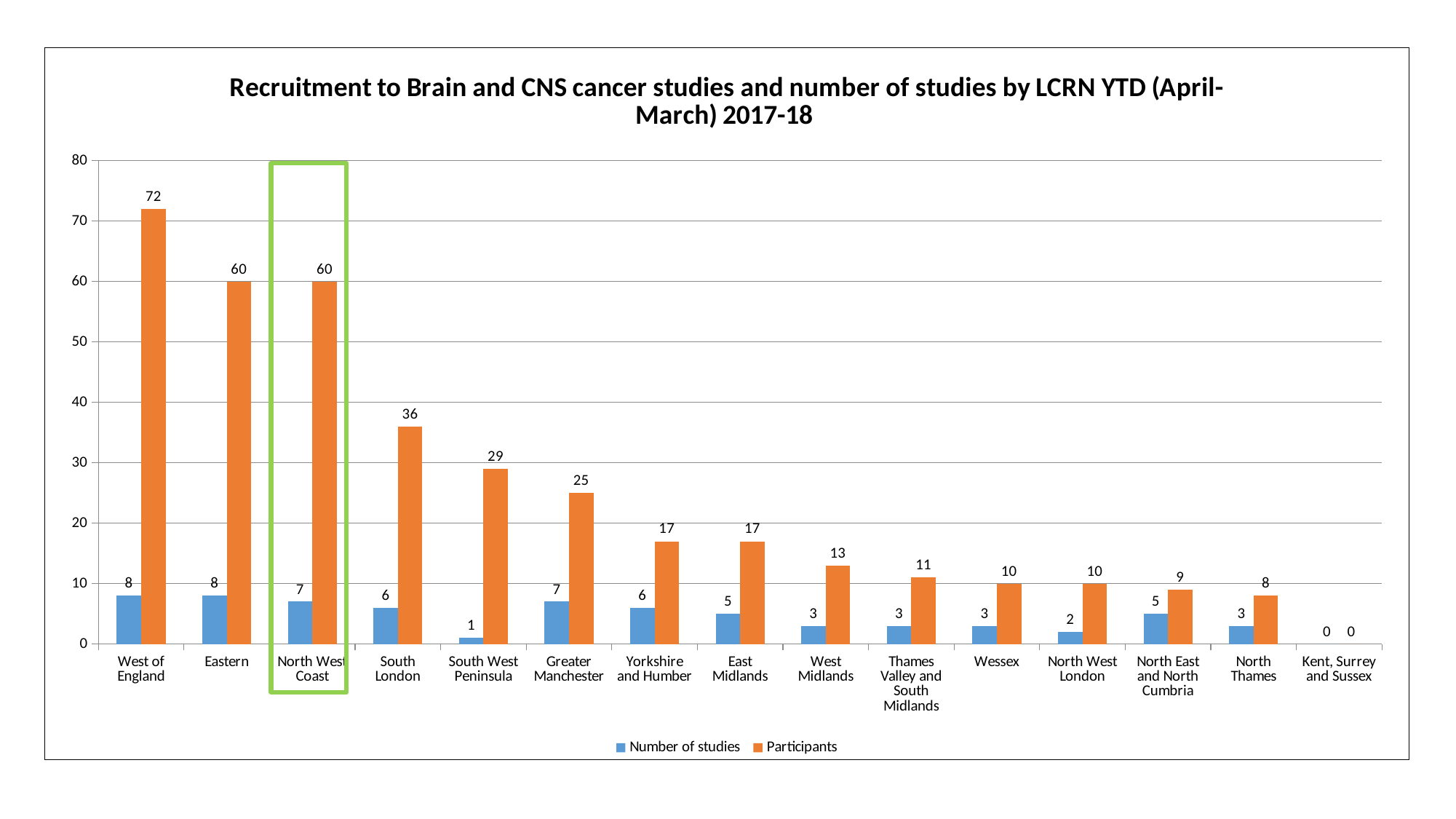
What is the Number of studies for South West Peninsula? 1 How many Participants are shown for West of England? 72 What kind of chart is this? Bar chart What is the difference in Participants between West of England and Eastern? 12 How many series does the legend list? 2 Which has more Participants, South London or Greater Manchester? South London Which LCRN is highlighted with a green box? North West Coast Which LCRN has the lowest number of Participants? Kent, Surrey and Sussex How many LCRNs are shown on the x axis? 15 Do the Participants values generally rise or fall from left to right along the x axis? Fall What is the Number of studies for North West Coast? 7 Which LCRN has the highest number of Participants? West of England